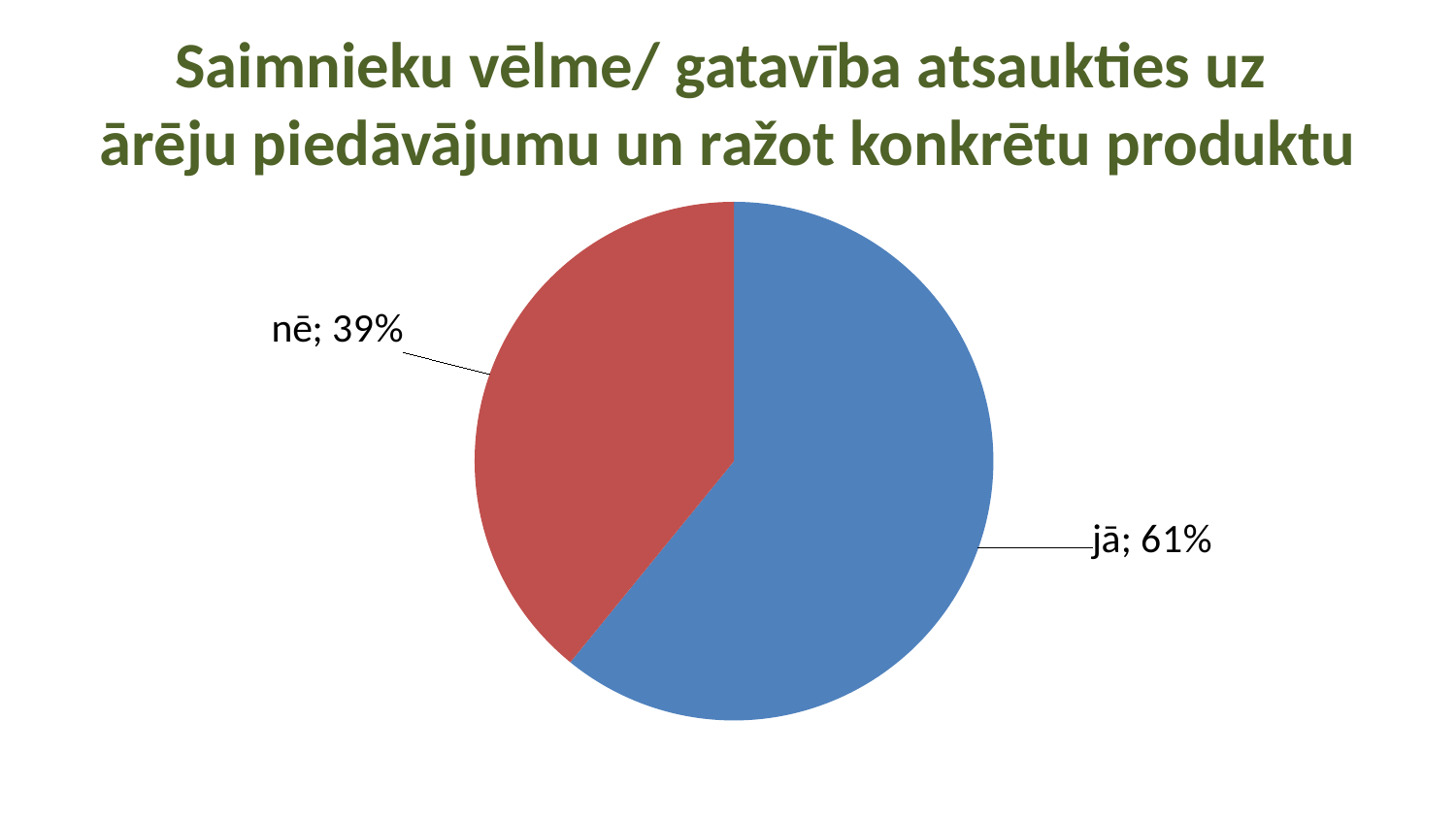
What colour is the "nē" slice? red Which slice is the smallest in the pie chart? nē What share of the pie does the "jā" slice represent? 61% Which slice is the largest in the pie chart? jā How many slices does the pie chart have? 2 What colour is the "jā" slice? blue What is the difference in percentage points between the "jā" and "nē" slices? 22% What share of the pie does the "nē" slice represent? 39% Which is larger, the "jā" slice or the "nē" slice? jā What kind of chart is shown on the slide? pie chart